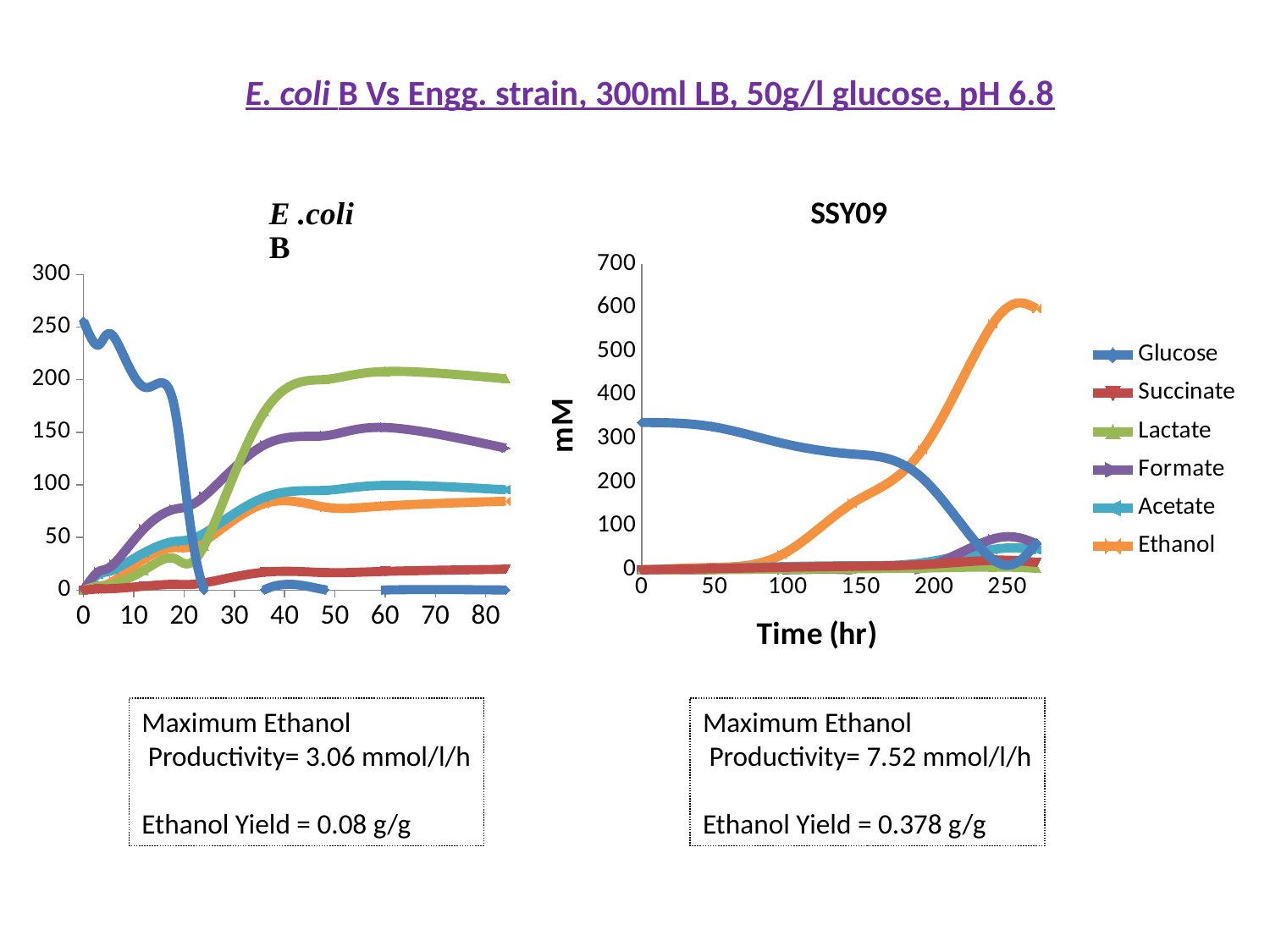
How many series does the legend list? 6 What is the x-axis title of the SSY09 chart? Time (hr) In the E. coli B chart, which series has the highest value at the end of the time course (around 80 hr)? Lactate In the SSY09 chart, does the Glucose series rise or fall over time? fall In the E. coli B chart, which is larger at 80 hr, Lactate or Formate? Lactate In the E. coli B chart, which series has the lowest value at the end of the time course (around 80 hr)? Glucose In the SSY09 chart, is the Ethanol value at 250 hr greater or less than 500? greater In the SSY09 chart, which series reaches the highest value? Ethanol In the SSY09 chart, is the Glucose value at 0 hr greater or less than 300? greater In the E. coli B chart, is the Lactate value at 80 hr greater or less than 150? greater In the SSY09 chart, which is larger at 250 hr, Ethanol or Glucose? Ethanol What kind of chart is the E. coli B chart on the left? line chart